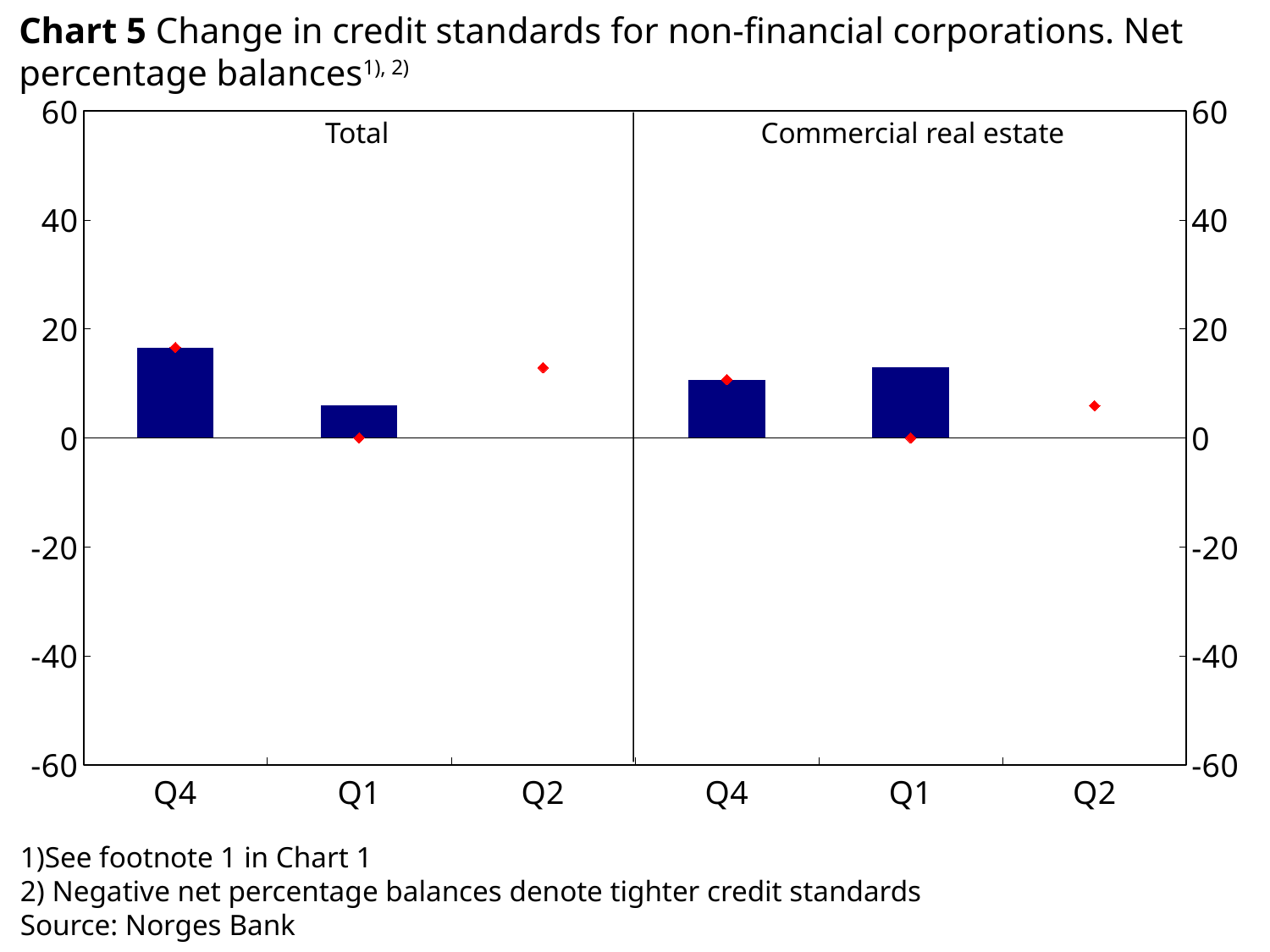
What kind of chart is shown on the slide? bar chart with red diamond markers (combination bar and marker chart) In the Total panel, do the bars rise or fall from Q4 to Q1? fall What is the source given for the chart? Norges Bank In the Total panel, is the bar for Q4 greater or less than 20? less How many quarters are labelled on the x axis of the Total panel? 3 How many panels does the chart have? 2 What are the labels of the two panels in the chart? Total and Commercial real estate In the Total panel, which bar is larger, Q4 or Q1? Q4 In the Commercial real estate panel, is the bar for Q1 greater or less than 0? greater In the Total panel, which quarter has the tallest bar? Q4 Which Q4 bar is larger, the one in the Total panel or the one in the Commercial real estate panel? Total In the Total panel, is the bar for Q1 greater or less than 20? less